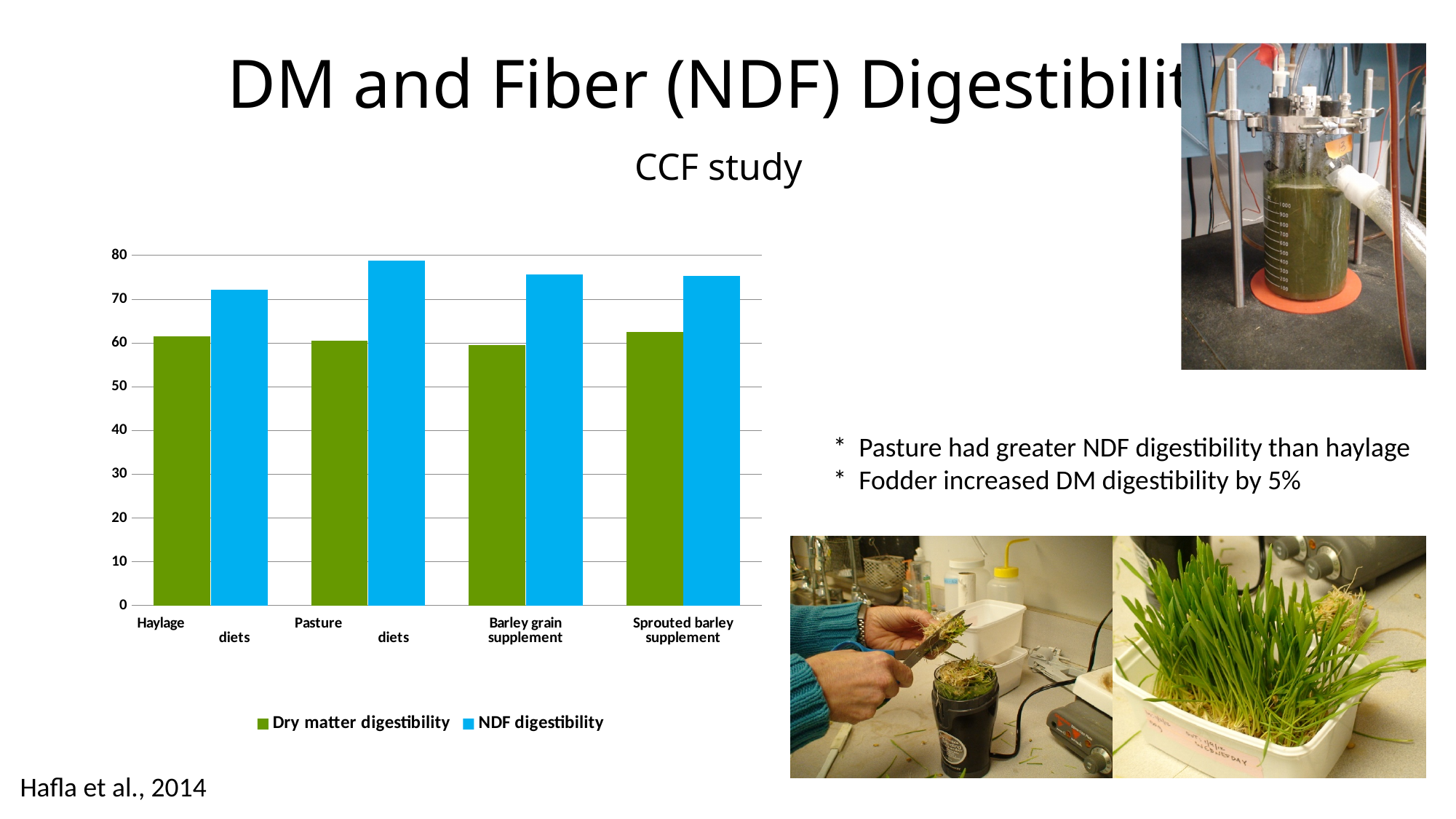
How many series does the chart legend list? 2 Which diet has the lowest NDF digestibility? Haylage What kind of chart is shown on the slide? bar chart How many diet categories are shown on the x axis of the chart? 4 Is the NDF digestibility for Barley grain supplement greater or less than 70? greater Which diet has the highest NDF digestibility? Pasture What is the highest value shown on the chart's vertical axis? 80 Which colour represents NDF digestibility in the chart? blue Is the NDF digestibility for Haylage greater or less than 70? greater For Haylage, which is larger: dry matter digestibility or NDF digestibility? NDF digestibility Is the dry matter digestibility for Pasture greater or less than 70? less